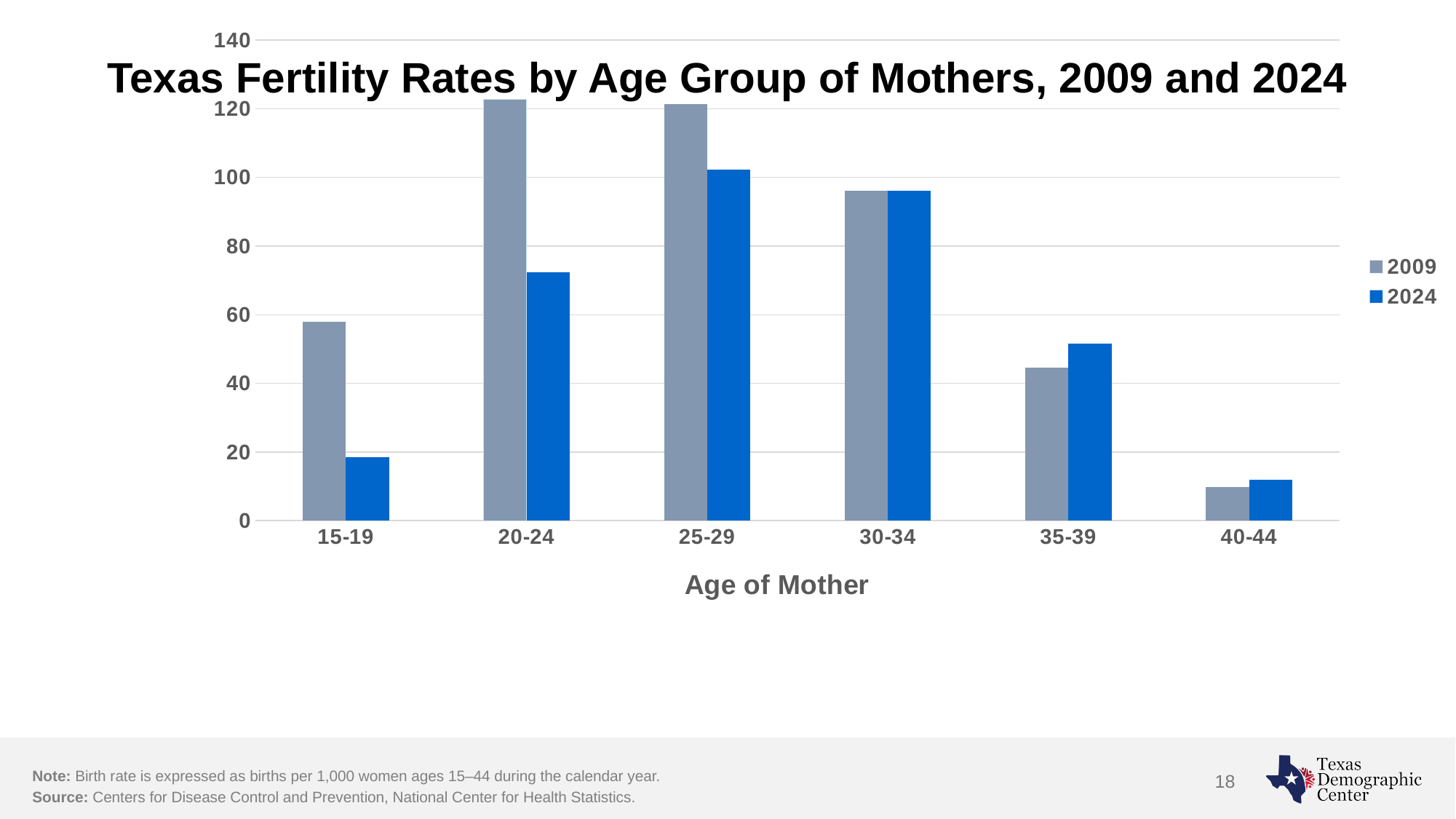
Is the 2024 value for the 20-24 age group greater or less than 80? less How many series does the legend list? 2 What kind of chart is shown on the slide? Bar chart Which age group has the highest fertility rate for 2024? 25-29 How many age groups are shown on the x axis? 6 Is the 2024 value for the 15-19 age group greater or less than 40? less Which age group has the lowest fertility rate for 2009? 40-44 Which age group has the lowest fertility rate for 2024? 40-44 What is the title of the x axis? Age of Mother For the 35-39 age group, which year has the larger fertility rate, 2009 or 2024? 2024 Is the 2009 value for the 20-24 age group greater or less than 100? greater For the 15-19 age group, which year has the larger fertility rate, 2009 or 2024? 2009